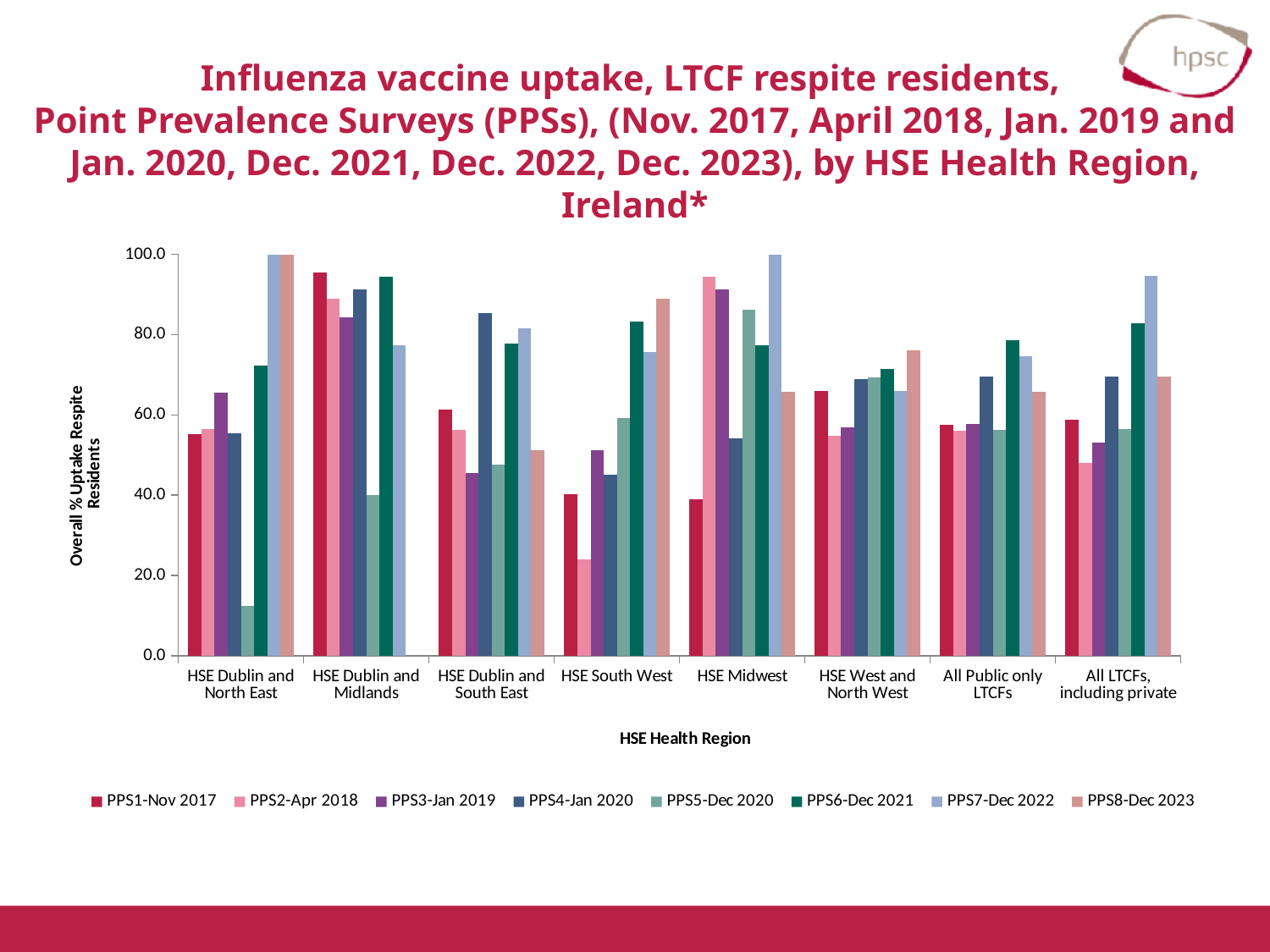
What is the title of the x axis? HSE Health Region How many series does the legend list? 8 Is the value for PPS1-Nov 2017 in HSE Dublin and Midlands greater or less than 80.0? greater Is the value for PPS7-Dec 2022 in All LTCFs, including private greater or less than 80.0? greater Is the value for PPS5-Dec 2020 in HSE Dublin and North East greater or less than 20.0? less What is the title of the y axis? Overall % Uptake Respite Residents How many categories are shown along the x axis? 8 In HSE Dublin and South East, which is larger: PPS4-Jan 2020 or PPS3-Jan 2019? PPS4-Jan 2020 What kind of chart is shown on the slide? bar chart Which series has the lowest value in HSE Dublin and North East? PPS5-Dec 2020 Which series has the lowest value in HSE Midwest? PPS1-Nov 2017